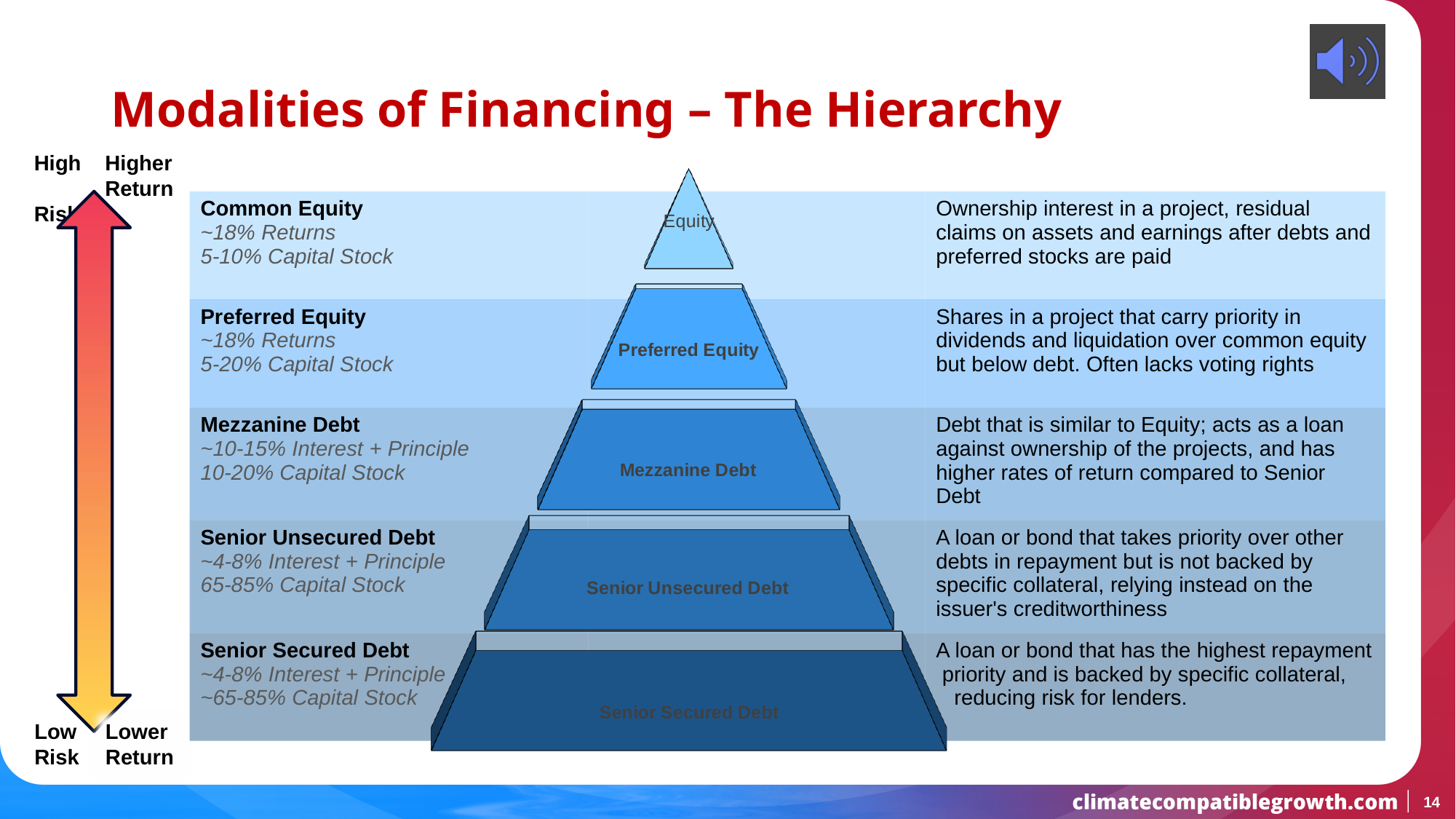
Which level of the pyramid is directly below Preferred Equity? Mezzanine Debt What returns are listed for Common Equity? ~18% Returns What capital stock range is listed for Senior Unsecured Debt? 65-85% Capital Stock How many levels does the pyramid have? 5 Which financing modality is at the base of the pyramid? Senior Secured Debt What kind of chart is shown on the slide? Pyramid diagram What capital stock range is listed for Preferred Equity? 5-20% Capital Stock Which financing modality is at the top of the pyramid? Equity What interest + principle range is listed for Mezzanine Debt? ~10-15% Interest + Principle What interest + principle range is listed for Senior Secured Debt? ~4-8% Interest + Principle According to the arrow on the left, does risk increase or decrease moving from the base to the top of the pyramid? Increase What capital stock range is listed for Common Equity? 5-10% Capital Stock